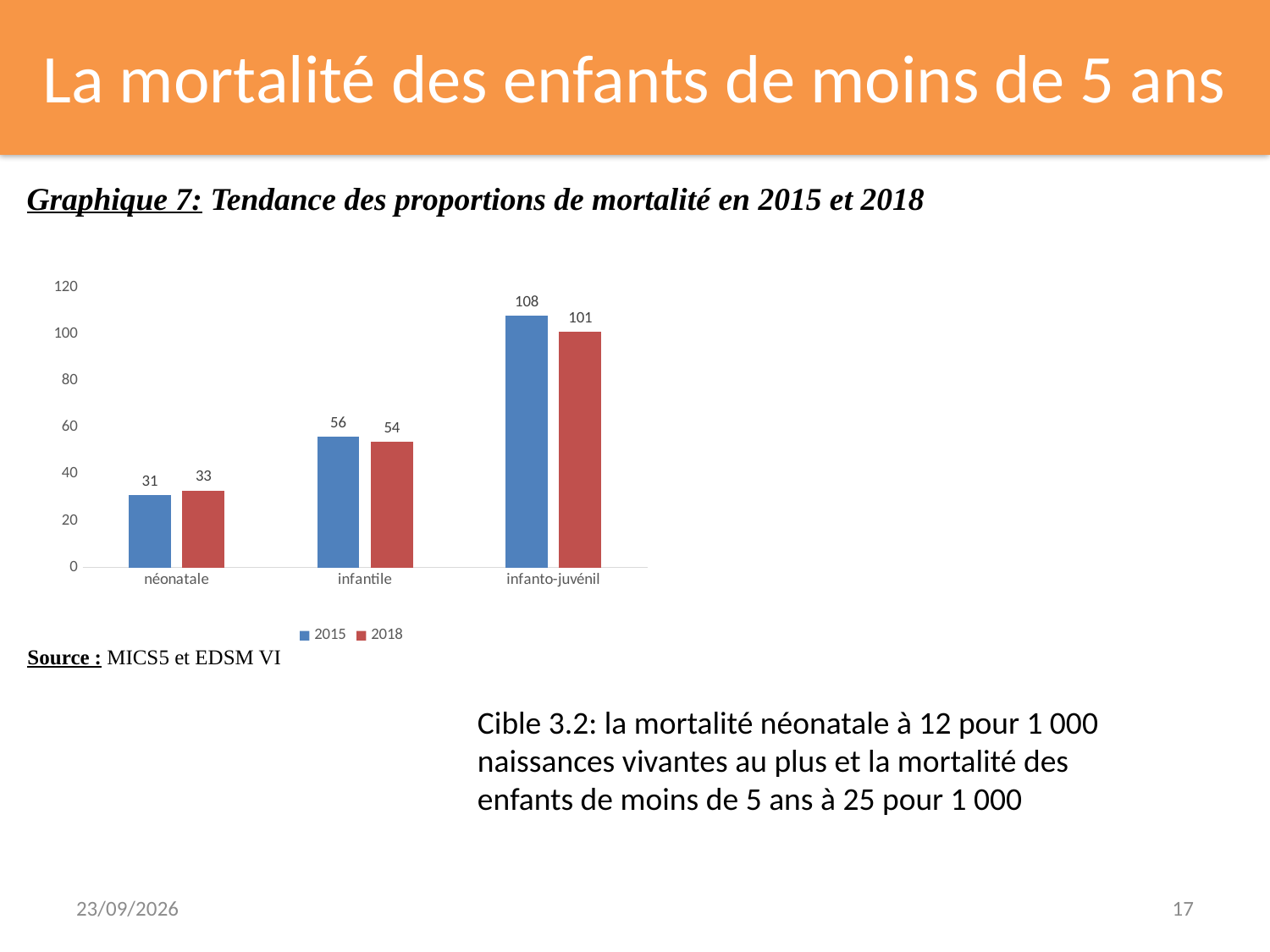
Which category has the lowest value in 2018? néonatale How many series does the legend list? 2 What is the value for infantile in 2018? 54 What is the value for néonatale in 2015? 31 What is the value for infanto-juvénil in 2018? 101 Which is larger for néonatale: the 2015 value or the 2018 value? 2018 Is the value for infantile in 2015 greater or less than 40? greater Which series is shown in red in the legend? 2018 Which category has the highest value in 2015? infanto-juvénil What is the difference between the 2015 and 2018 values for infanto-juvénil? 7 What kind of chart is shown on the slide? bar chart How many categories are shown on the x axis? 3